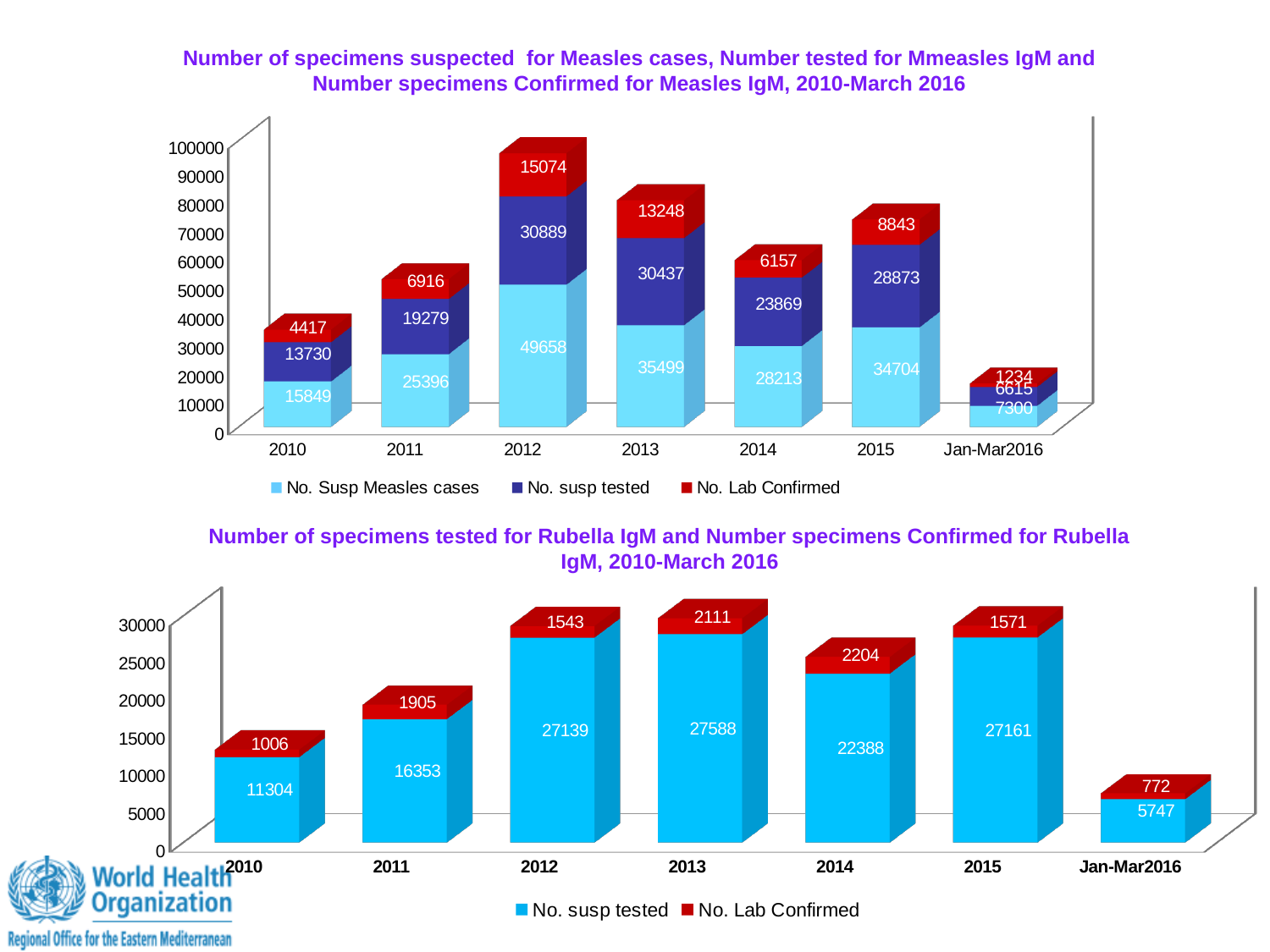
In the top chart (Measles), is No. susp tested for 2013 larger than No. susp tested for 2014? Yes, 2013 (30437) is larger In the top chart (Measles), which year has the highest No. Lab Confirmed value? 2012 In the top chart (Measles), which category has the lowest No. Susp Measles cases value? Jan-Mar2016 In the bottom chart (Rubella), what is the value of No. susp tested for 2014? 22388 How many categories are shown on the x axis of the bottom chart (Rubella)? 7 In the bottom chart (Rubella), what is the difference between No. susp tested in 2013 and 2012? 449 In the top chart (Measles), what is the total of the stacked bar for 2010? 33996 In the bottom chart (Rubella), what is the total of the stacked bar for 2013? 29699 In the top chart (Measles), how many series does the legend list? 3 In the top chart (Measles), what is the value of No. Susp Measles cases for 2012? 49658 In the top chart (Measles), what is the value of No. Lab Confirmed for 2015? 8843 In the bottom chart (Rubella), which year has the highest No. Lab Confirmed value? 2014